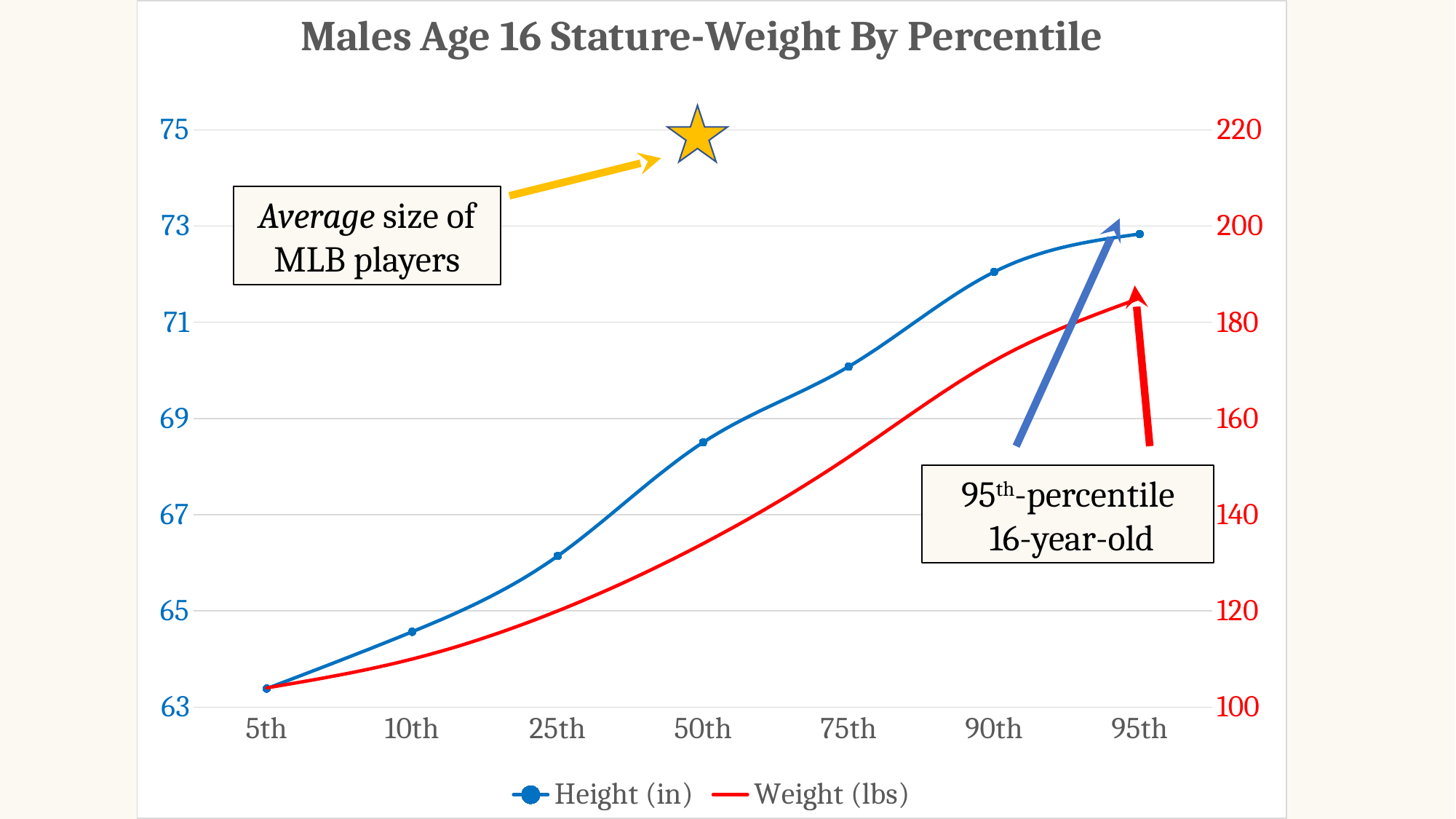
How many series does the legend list? 2 Do the Height (in) values rise or fall from the 5th to the 95th percentile? rise Is the Weight (lbs) value for the 10th percentile greater or less than 120? less Is the Height (in) value for the 10th percentile greater or less than 65? less Is the Weight (lbs) value for the 95th percentile greater or less than 180? greater Which percentile has the lowest Height (in) value? 5th What is the title of the chart? Males Age 16 Stature-Weight By Percentile Which series is drawn in red? Weight (lbs) Which percentile has the highest Weight (lbs) value? 95th What kind of chart is shown on the slide? line chart How many percentile categories are plotted along the x axis? 7